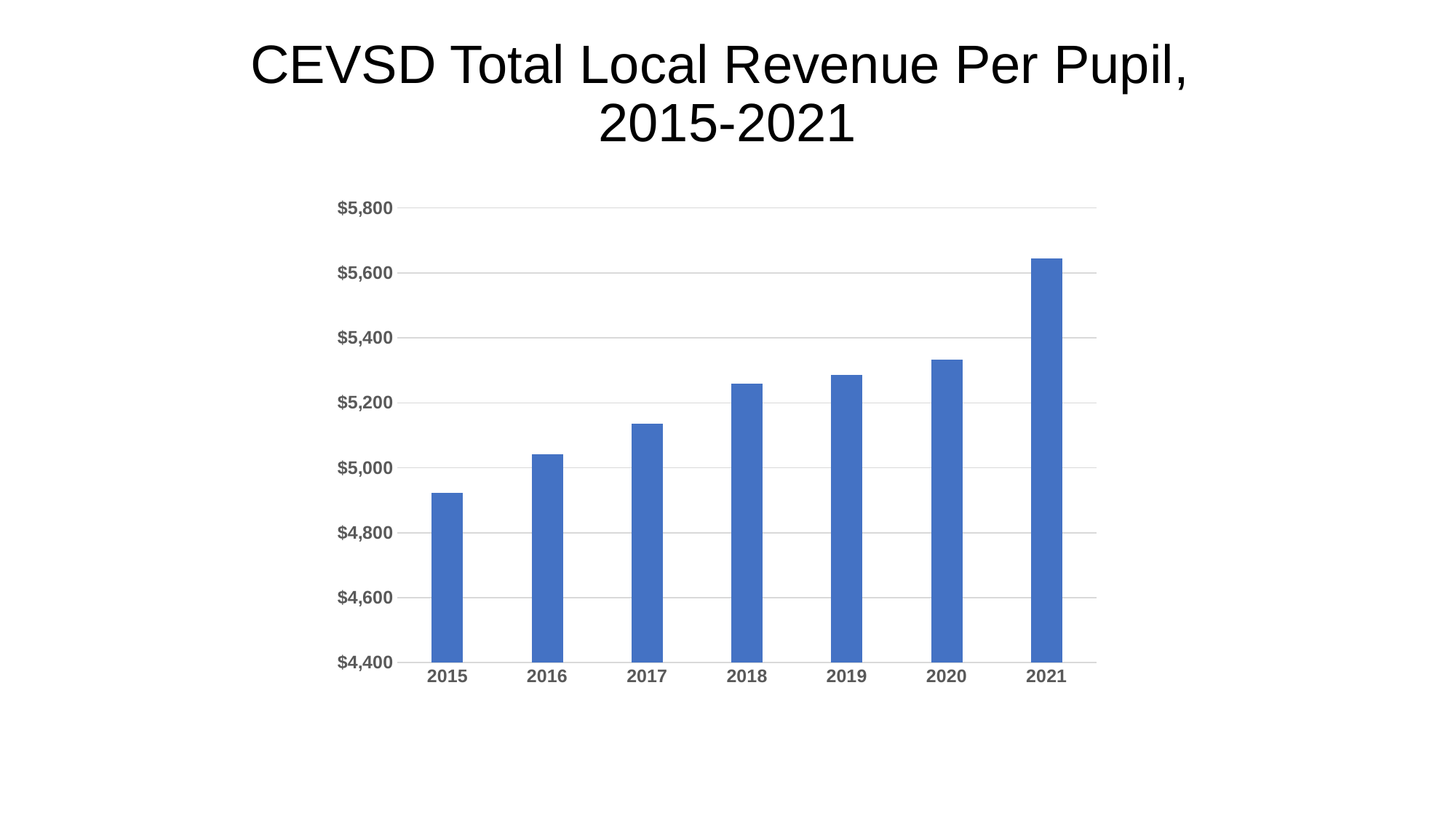
Do the values rise or fall from 2015 to 2021? Rise Which is larger, the value for 2016 or the value for 2018? 2018 Is the value for 2017 greater or less than $5,200? less Which year has the lowest total local revenue per pupil? 2015 Is the value for 2018 greater or less than $5,200? greater Which year has the highest total local revenue per pupil? 2021 Is the value for 2015 greater or less than $5,000? less What is the title of the chart? CEVSD Total Local Revenue Per Pupil, 2015-2021 How many years are shown on the x axis of the chart? 7 What kind of chart is shown on the slide? Bar chart